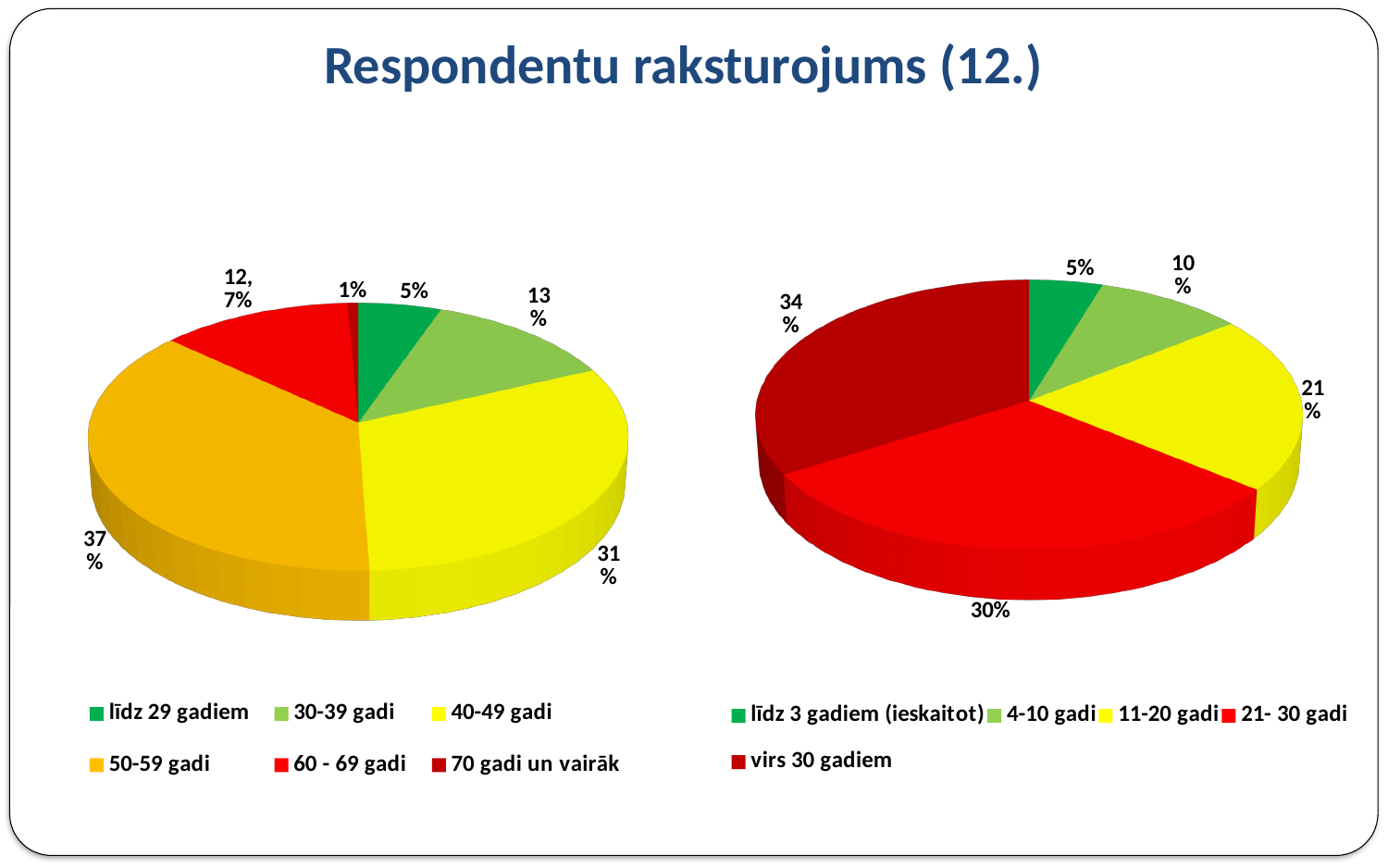
In the right pie chart, which is larger: the share for 11-20 gadi or the share for 4-10 gadi? 11-20 gadi In the right pie chart, which category has the largest share? virs 30 gadiem In the right pie chart, how many categories does the legend list? 5 In the left pie chart, which category has the smallest share? 70 gadi un vairāk What type of charts are shown on the slide? Pie charts In the left pie chart, how many categories does the legend list? 6 In the left pie chart, what is the difference between the shares for 50-59 gadi and 40-49 gadi? 6% In the left pie chart, what is the share for 60 - 69 gadi? 12,7% In the left pie chart, which category has the largest share? 50-59 gadi In the right pie chart, which category has the smallest share? līdz 3 gadiem (ieskaitot) In the left pie chart, what is the share for 50-59 gadi? 37% In the right pie chart, what is the share for 21- 30 gadi? 30%